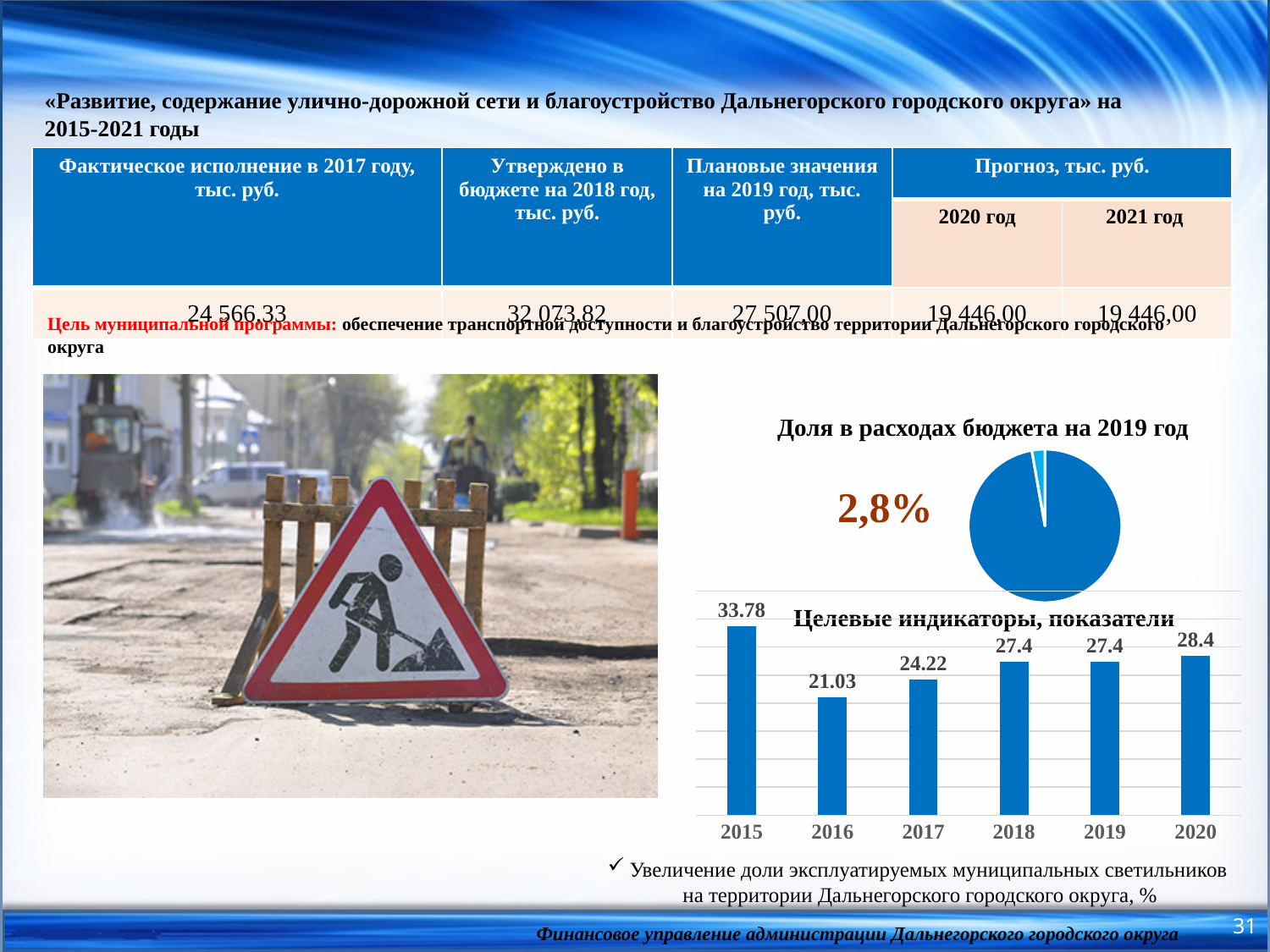
In the bar chart 'Целевые индикаторы, показатели', what is the value for 2015? 33.78 In the bar chart 'Целевые индикаторы, показатели', what is the difference between the values for 2015 and 2016? 12.75 In the bar chart 'Целевые индикаторы, показатели', what is the value for 2016? 21.03 What kind of chart is 'Целевые индикаторы, показатели'? bar chart In the bar chart 'Целевые индикаторы, показатели', what is the value for 2017? 24.22 What kind of chart is 'Доля в расходах бюджета на 2019 год'? pie chart In the pie chart 'Доля в расходах бюджета на 2019 год', what share is labelled for the small slice? 2,8% How many years are shown in the bar chart 'Целевые индикаторы, показатели'? 6 In the bar chart 'Целевые индикаторы, показатели', what is the value for 2020? 28.4 In the bar chart 'Целевые индикаторы, показатели', which year has the lowest value? 2016 In the bar chart 'Целевые индикаторы, показатели', which year has the highest value? 2015 In the bar chart 'Целевые индикаторы, показатели', which is larger, the value for 2017 or the value for 2020? 2020